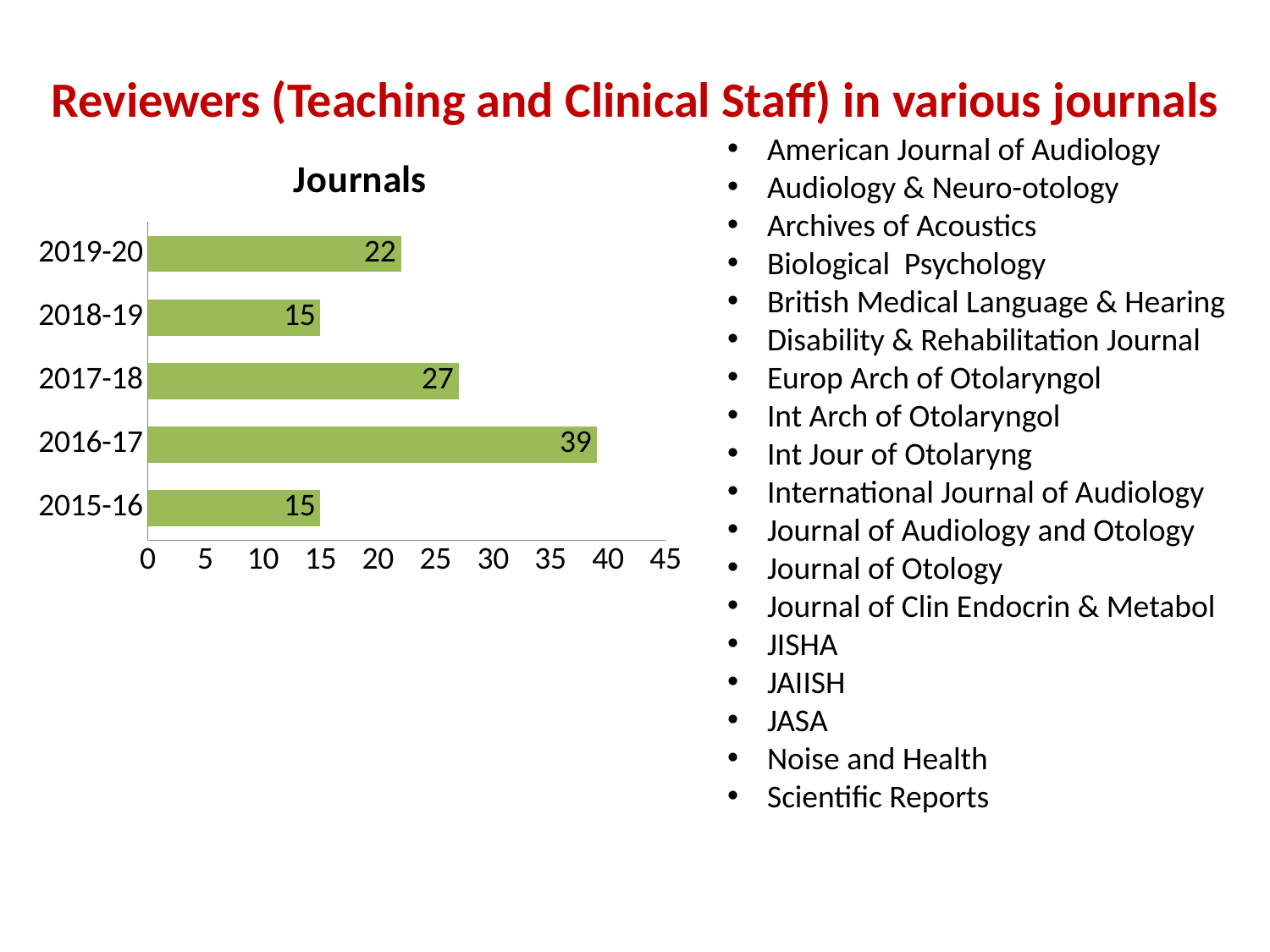
What is the difference between the values for 2016-17 and 2017-18? 12 Which year has the highest value? 2016-17 Is the value for 2016-17 greater or less than 35? greater Which is larger, the value for 2019-20 or the value for 2017-18? 2017-18 What is the difference between the values for 2019-20 and 2018-19? 7 What is the value for 2017-18? 27 What is the value for 2016-17? 39 What kind of chart is shown? bar chart How many years are shown in the chart? 5 Which years share the lowest value? 2015-16 and 2018-19 What is the title of the chart? Journals What is the value for 2019-20? 22